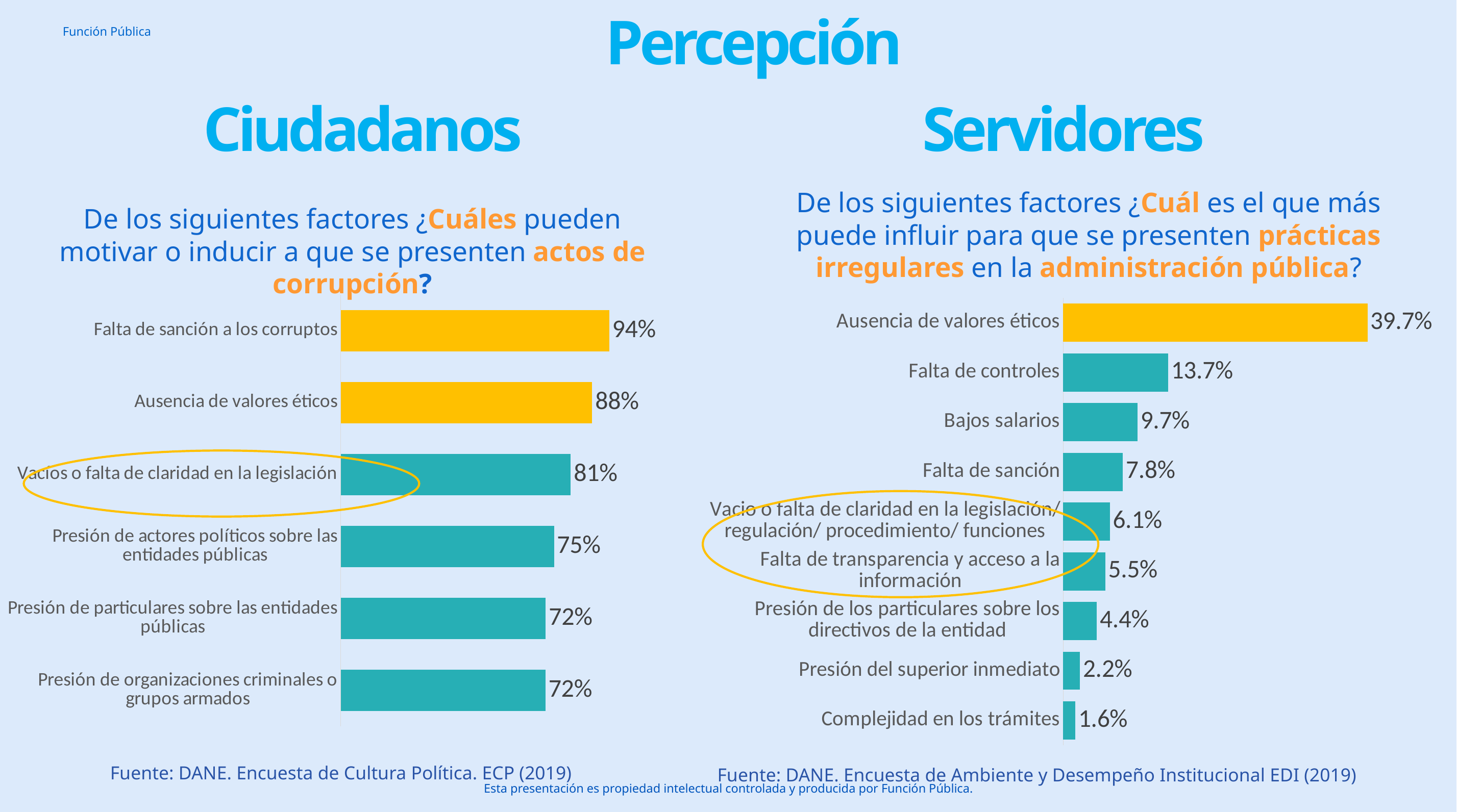
In the Ciudadanos chart, how many categories are shown? 6 In the Servidores chart, how many categories are shown? 9 In the Ciudadanos chart, what is the difference between "Falta de sanción a los corruptos" and "Ausencia de valores éticos"? 6% In the Ciudadanos chart, what is the value for "Falta de sanción a los corruptos"? 94% In the Servidores chart, what is the value for "Falta de transparencia y acceso a la información"? 5.5% In the Servidores chart, what is the value for "Ausencia de valores éticos"? 39.7% In the Servidores chart, what is the difference between "Falta de controles" and "Bajos salarios"? 4.0% In the Ciudadanos chart, what is the value for "Vacíos o falta de claridad en la legislación"? 81% In the Servidores chart, which is larger: "Bajos salarios" or "Falta de sanción"? Bajos salarios In the Ciudadanos chart, which category has the highest value? Falta de sanción a los corruptos What type of chart is the Servidores chart? Bar chart In the Servidores chart, which category has the lowest value? Complejidad en los trámites